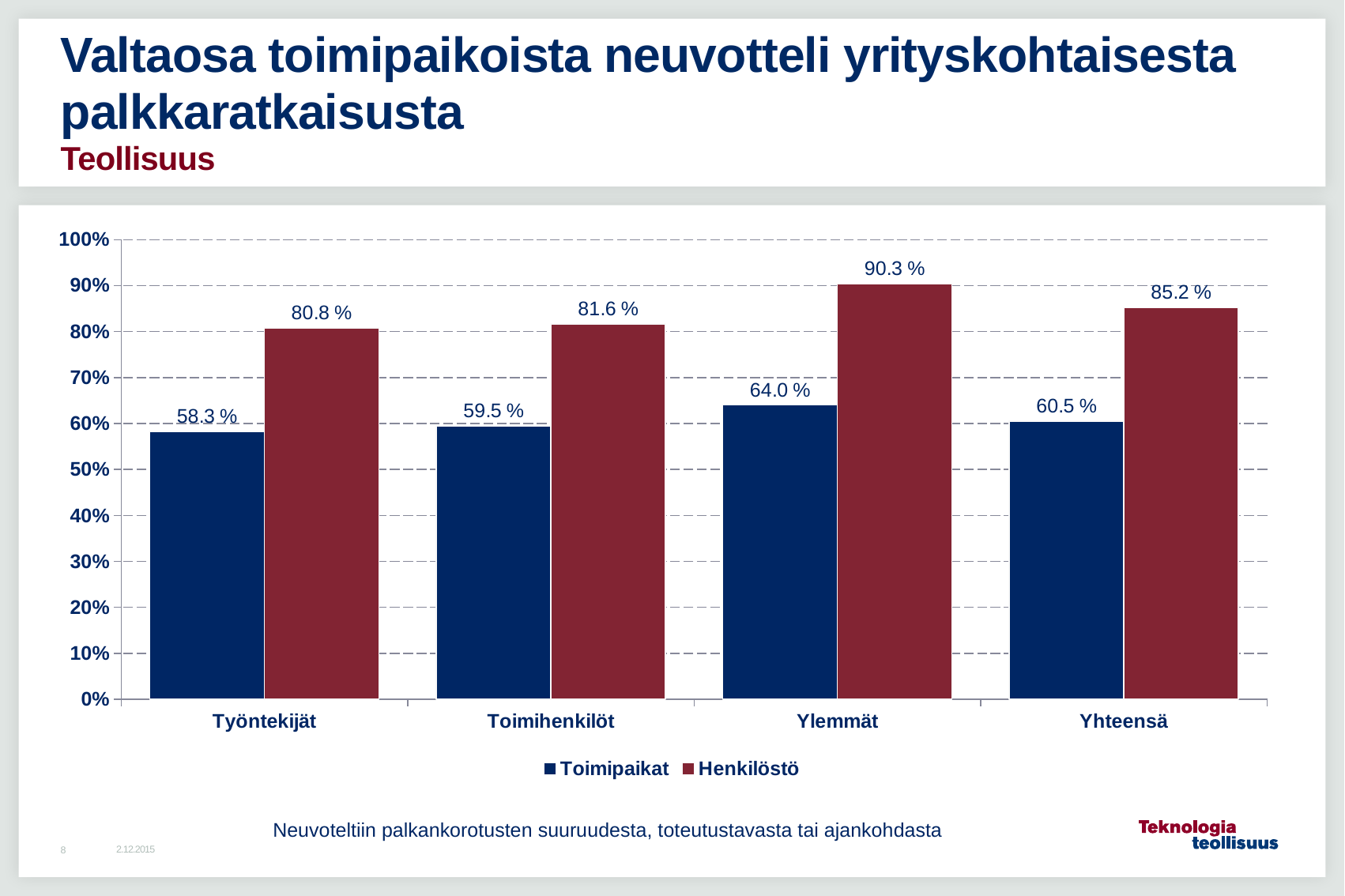
How many categories are shown on the x axis? 4 What is the Henkilöstö value for Ylemmät? 90.3 % Do the Toimipaikat values rise or fall from Työntekijät to Ylemmät? Rise What colour are the Henkilöstö bars? Dark red What is the Toimipaikat value for Työntekijät? 58.3 % Which category has the highest Toimipaikat value? Ylemmät What is the Henkilöstö value for Yhteensä? 85.2 % What is the difference between the Henkilöstö and Toimipaikat values for Toimihenkilöt? 22.1 % Which category has the lowest Henkilöstö value? Työntekijät How many series does the legend list? 2 Which is larger for Yhteensä, the Toimipaikat value or the Henkilöstö value? Henkilöstö What kind of chart is shown on the slide? Bar chart